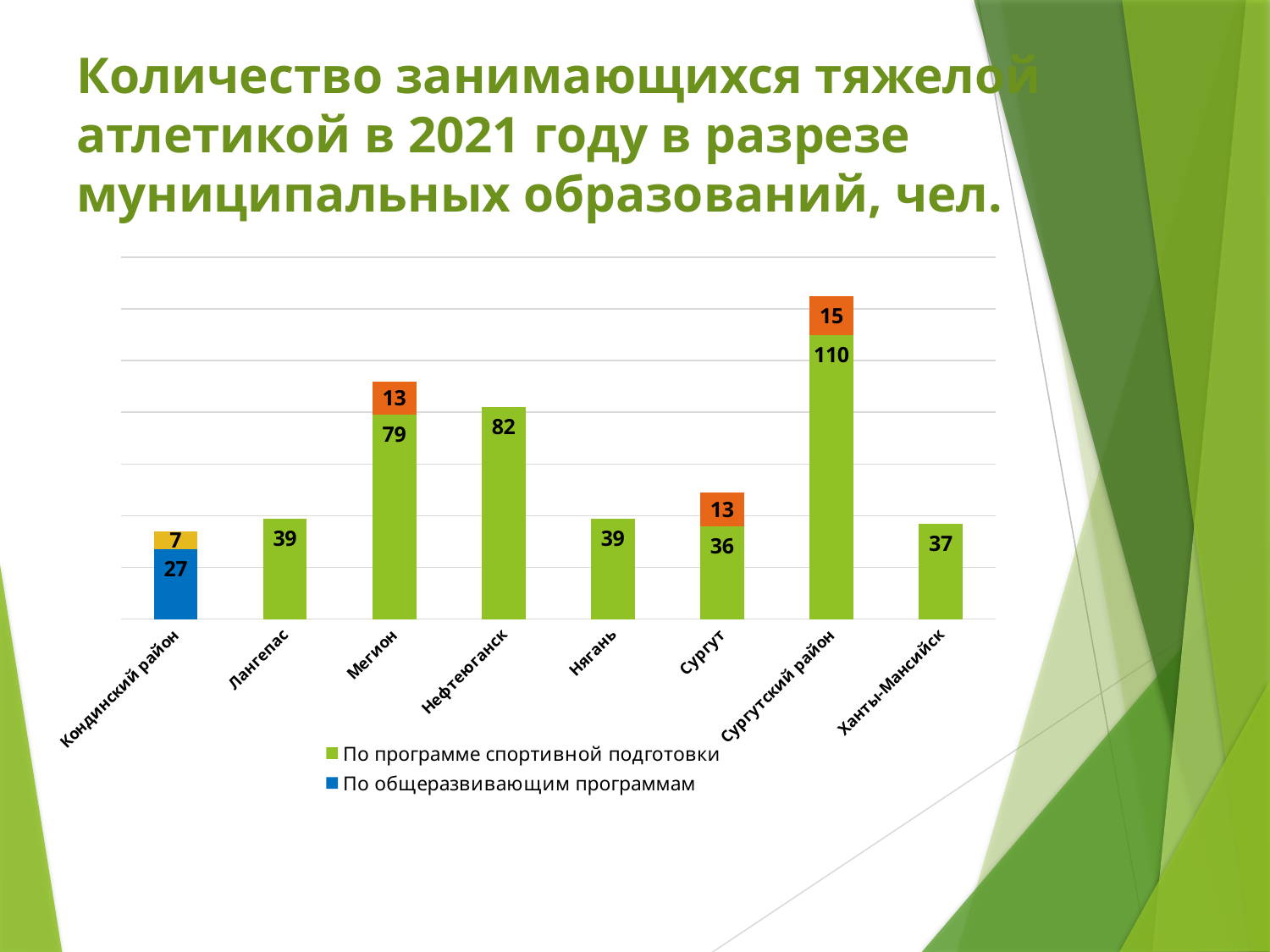
What is the value for Нефтеюганск in the chart? 82 What is the total of the stacked bar for Мегион? 92 What is the value of the blue segment (По общеразвивающим программам) for Кондинский район? 27 How many municipalities are shown on the x axis of the chart? 8 What is the value of the green segment (По программе спортивной подготовки) for Сургутский район? 110 Which municipality has the tallest bar in the chart? Сургутский район What is the value of the green segment for Сургут? 36 Which is larger: the green segment for Мегион or the value for Нефтеюганск? Нефтеюганск What is the difference between the values for Нефтеюганск and Ханты-Мансийск? 45 What kind of chart is shown on the slide? stacked bar chart How many series does the chart legend list? 2 What is the total of the stacked bar for Сургутский район? 125